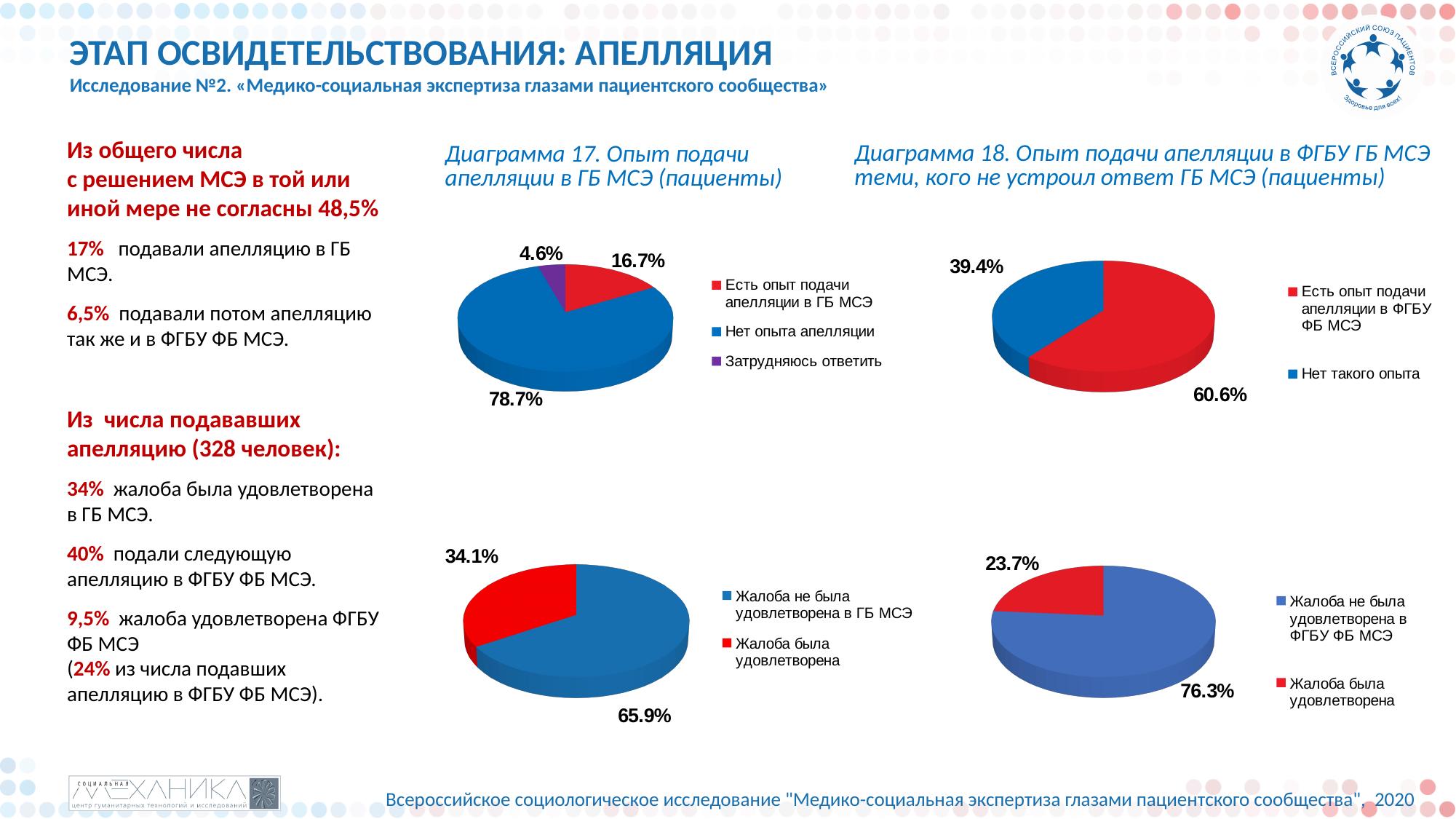
In the bottom-left pie chart, what share is labelled "Жалоба не была удовлетворена в ГБ МСЭ"? 65.9% In the bottom-right pie chart, what share is labelled "Жалоба не была удовлетворена в ФГБУ ФБ МСЭ"? 76.3% In the chart titled "Диаграмма 17. Опыт подачи апелляции в ГБ МСЭ (пациенты)", what share is labelled "Затрудняюсь ответить"? 4.6% What kind of chart is the chart titled "Диаграмма 18. Опыт подачи апелляции в ФГБУ ГБ МСЭ теми, кого не устроил ответ ГБ МСЭ (пациенты)"? Pie chart In the chart titled "Диаграмма 17. Опыт подачи апелляции в ГБ МСЭ (пациенты)", what share is labelled "Есть опыт подачи апелляции в ГБ МСЭ"? 16.7% How many pie charts are shown on the slide? 4 In the chart titled "Диаграмма 17. Опыт подачи апелляции в ГБ МСЭ (пациенты)", which category has the largest share? Нет опыта апелляции In the chart titled "Диаграмма 18. Опыт подачи апелляции в ФГБУ ГБ МСЭ теми, кого не устроил ответ ГБ МСЭ (пациенты)", what share is labelled "Нет такого опыта"? 39.4% In the bottom-left pie chart, what share is labelled "Жалоба была удовлетворена"? 34.1% Which is larger: the "Жалоба была удовлетворена" slice in the bottom-left pie chart or the "Жалоба была удовлетворена" slice in the bottom-right pie chart? Bottom-left (34.1%) In the chart titled "Диаграмма 18. Опыт подачи апелляции в ФГБУ ГБ МСЭ теми, кого не устроил ответ ГБ МСЭ (пациенты)", what is the difference between the two slices? 21.2% How many entries does the legend of the chart titled "Диаграмма 17. Опыт подачи апелляции в ГБ МСЭ (пациенты)" list? 3